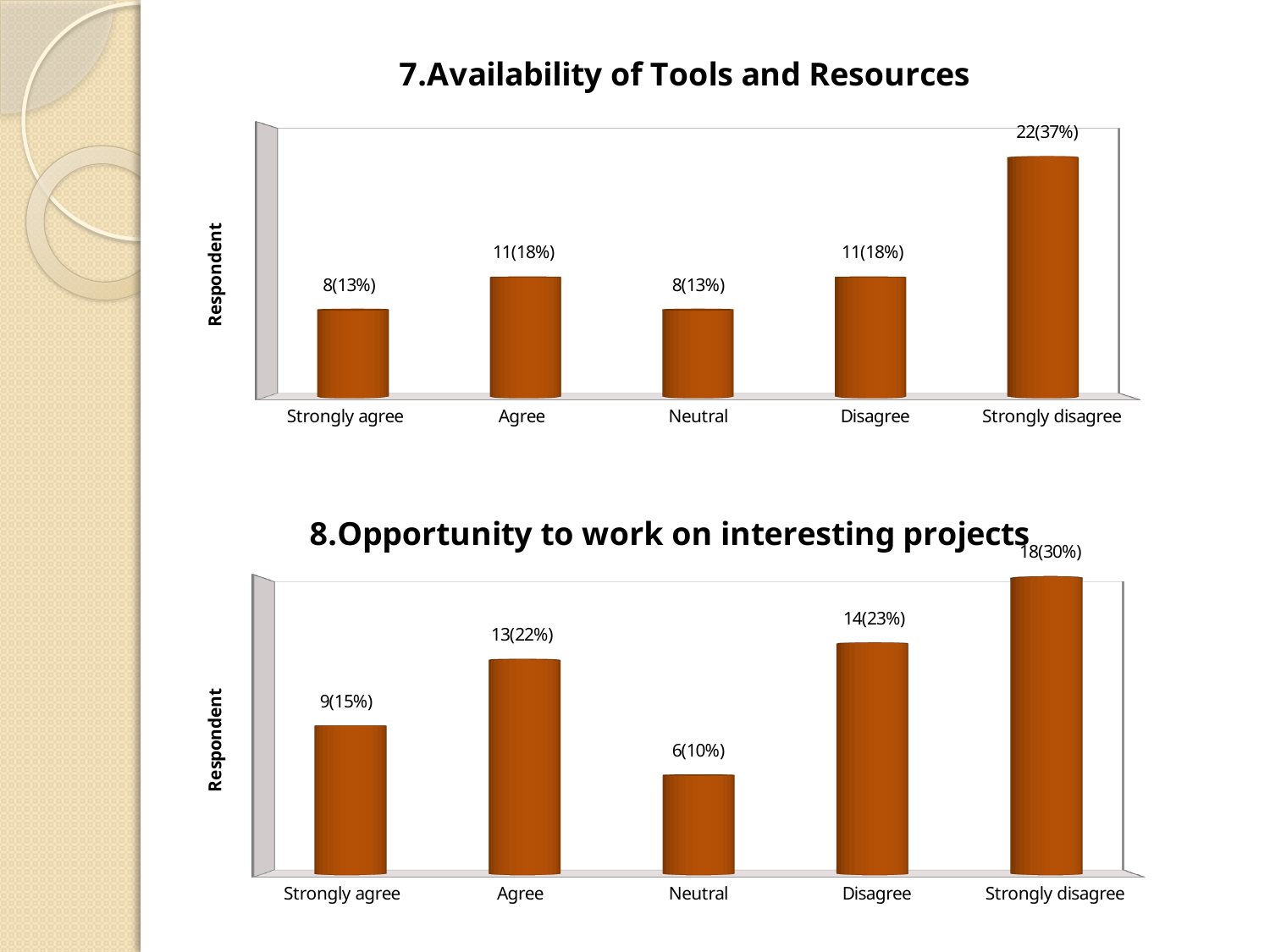
In the chart titled '7.Availability of Tools and Resources', what is the data label for Neutral? 8(13%) In the chart titled '8.Opportunity to work on interesting projects', which is larger, Agree or Strongly agree? Agree In the chart titled '8.Opportunity to work on interesting projects', what is the data label for Strongly agree? 9(15%) In the chart titled '7.Availability of Tools and Resources', what is the data label for Strongly disagree? 22(37%) In the chart titled '7.Availability of Tools and Resources', what is the difference in respondents between Strongly disagree and Agree? 11 In the chart titled '8.Opportunity to work on interesting projects', what is the difference in respondents between Strongly disagree and Neutral? 12 In the chart titled '7.Availability of Tools and Resources', which category has the highest value? Strongly disagree What is the y-axis label of the chart titled '7.Availability of Tools and Resources'? Respondent In the chart titled '8.Opportunity to work on interesting projects', what is the data label for Disagree? 14(23%) In the chart titled '8.Opportunity to work on interesting projects', which category has the lowest value? Neutral What kind of chart is the chart titled '8.Opportunity to work on interesting projects'? Bar chart In the chart titled '7.Availability of Tools and Resources', how many categories are shown on the x axis? 5